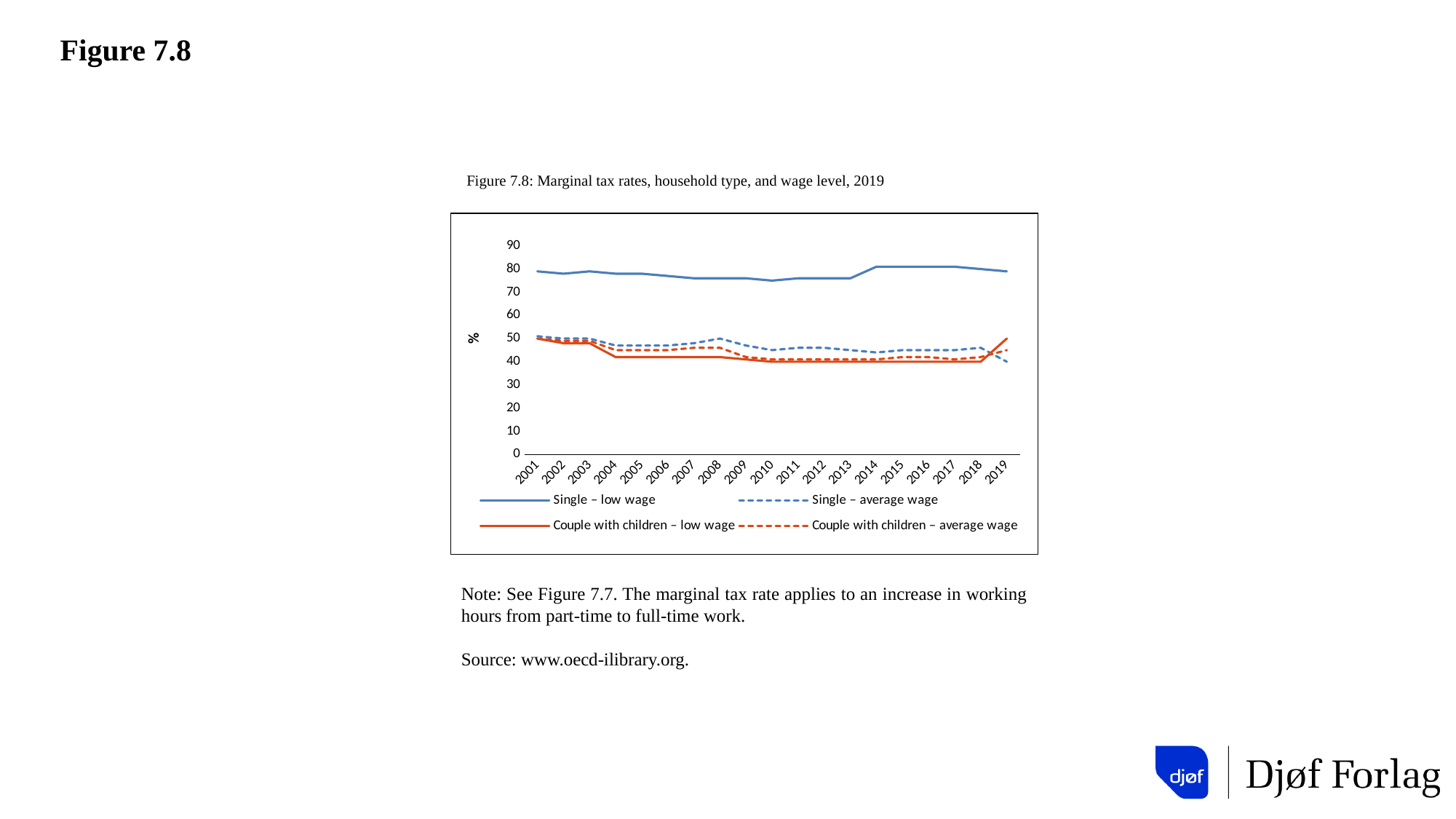
How many years are plotted along the x axis? 19 Does the Couple with children – low wage series rise or fall from 2001 to 2004? Fall Is the value for Single – low wage in 2010 greater or less than 80? less In 2019, which is larger: Single – low wage or Couple with children – low wage? Single – low wage How many series does the legend list? 4 Which series has the highest values throughout the period? Single – low wage What kind of chart is shown on the slide? Line chart Is the value for Single – low wage in 2001 greater or less than 70? greater In 2019, which is larger: Couple with children – low wage or Single – average wage? Couple with children – low wage Does the Single – low wage series rise or fall from 2013 to 2014? Rise Is the value for Couple with children – low wage in 2004 greater or less than 50? less What is the label on the y axis? %